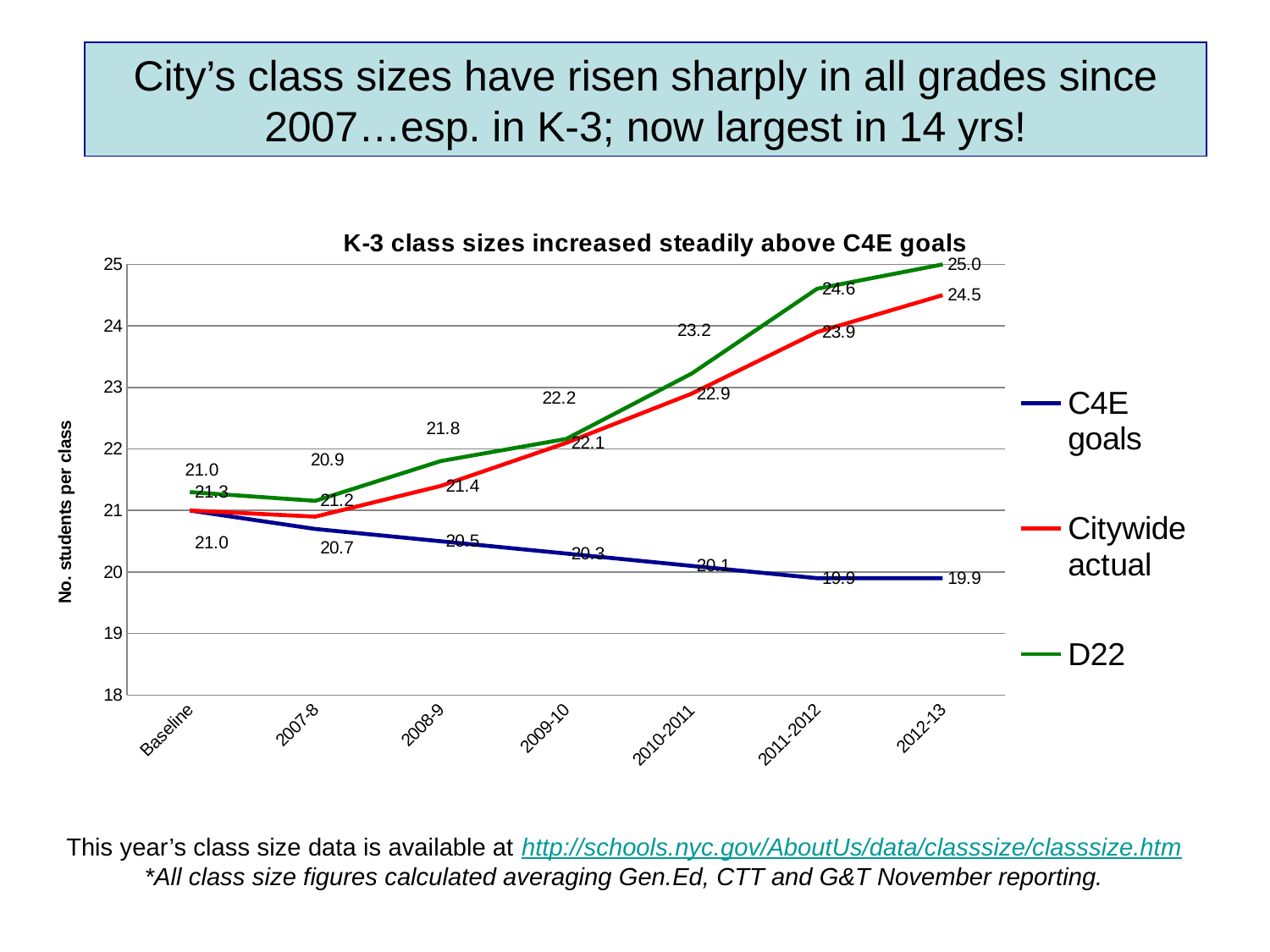
In which year does the D22 series reach its highest value? 2012-13 How many series does the legend list? 3 In 2011-2012, which is larger: the D22 value or the Citywide actual value? D22 What is the difference between the D22 and Citywide actual values in 2012-13? 0.5 Do the C4E goals values rise or fall from Baseline to 2012-13? Fall What is the difference between the Citywide actual and C4E goals values in 2012-13? 4.6 How many points are plotted along the x axis for each series? 7 What is the D22 value for 2012-13? 25.0 What kind of chart is shown on the slide? Line chart What is the Citywide actual value for 2010-2011? 22.9 What is the Citywide actual value for 2012-13? 24.5 What is the C4E goals value for 2012-13? 19.9